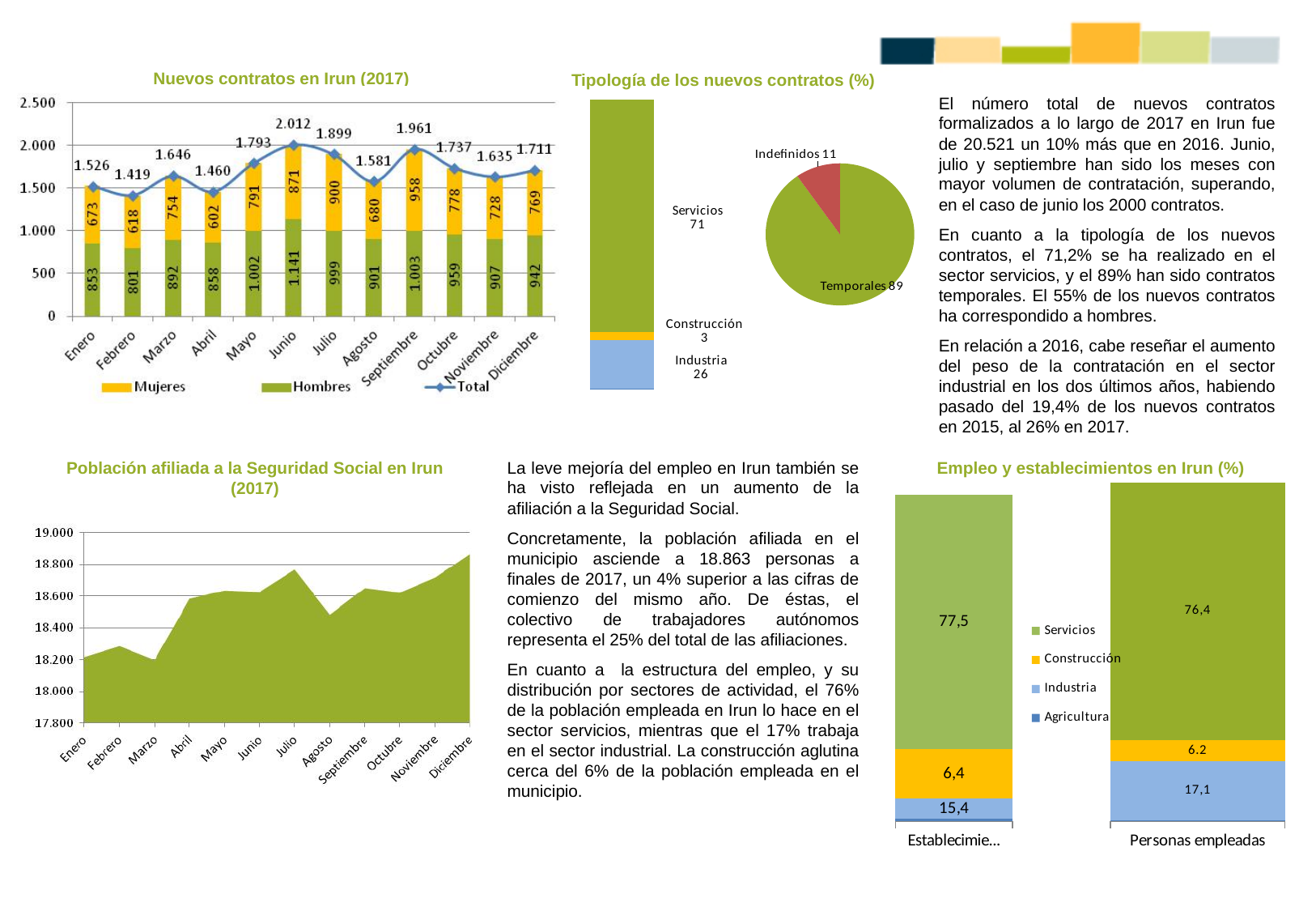
In the 'Población afiliada a la Seguridad Social en Irun (2017)' chart, is the value for Julio greater or less than 18.600? greater What kind of chart is 'Población afiliada a la Seguridad Social en Irun (2017)'? area chart In the 'Nuevos contratos en Irun (2017)' chart, what is the Total value for Junio? 2.012 In the 'Tipología de los nuevos contratos (%)' pie chart, what is the value for Temporales? 89 In the 'Tipología de los nuevos contratos (%)' stacked bar, what is the value for Industria? 26 In the 'Nuevos contratos en Irun (2017)' chart, is the Hombres value for Mayo larger or the Hombres value for Julio? Mayo In the 'Nuevos contratos en Irun (2017)' chart, what is the difference between the Hombres and Mujeres values for Abril? 256 In the 'Nuevos contratos en Irun (2017)' chart, which month has the lowest Total? Febrero In the 'Nuevos contratos en Irun (2017)' chart, how many series does the legend list? 3 In the 'Nuevos contratos en Irun (2017)' chart, what is the Mujeres value for Septiembre? 958 In the 'Empleo y establecimientos en Irun (%)' chart, how many series does the legend list? 4 In the 'Empleo y establecimientos en Irun (%)' chart, what is the Servicios value for Personas empleadas? 76,4